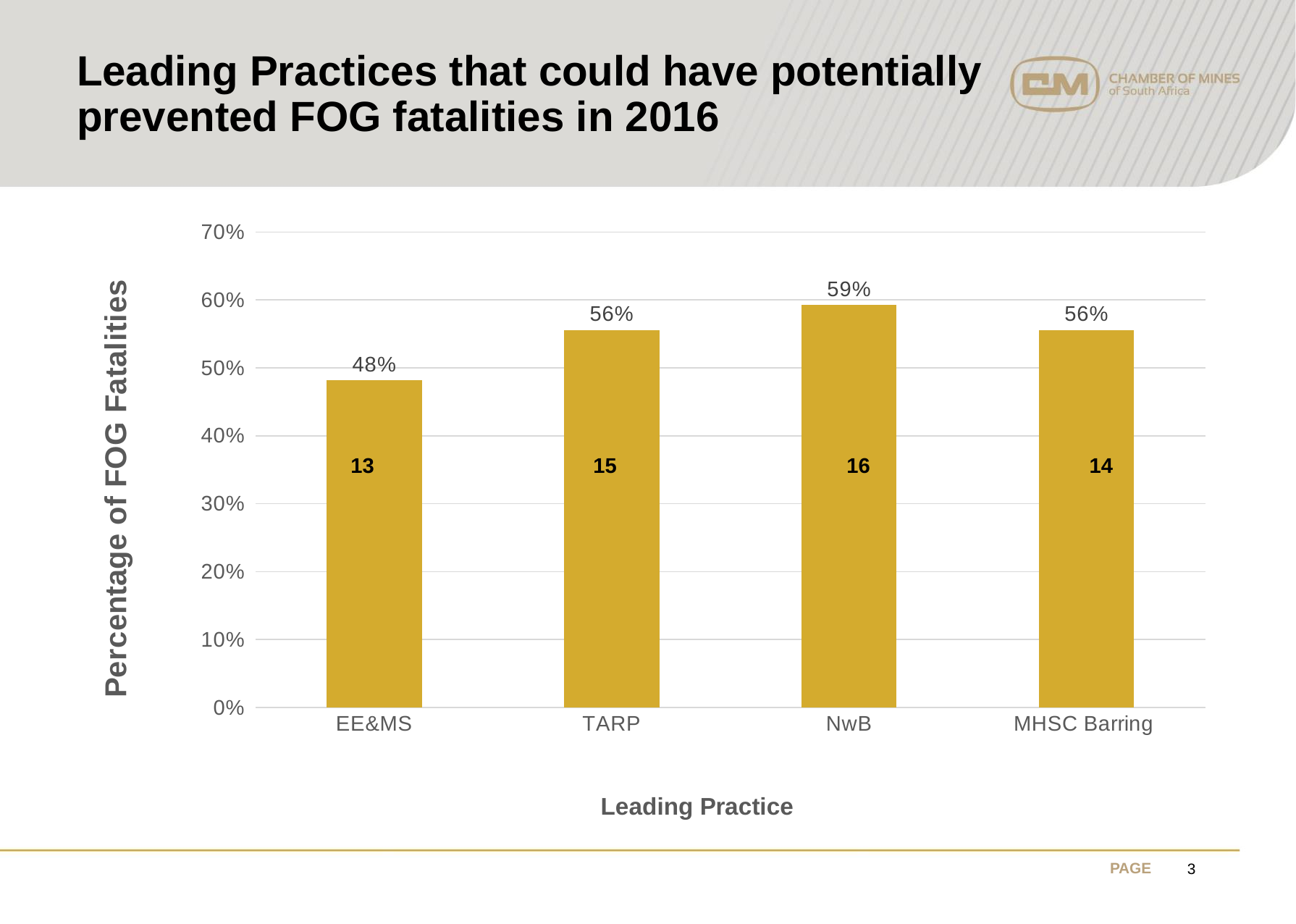
What is the difference in percentage points between NwB and EE&MS? 11 What number is printed inside the MHSC Barring bar? 14 What number is printed inside the TARP bar? 15 Which leading practice has the lowest percentage of FOG fatalities? EE&MS Is the value for EE&MS greater or less than 50%? less What percentage of FOG fatalities is shown for NwB? 59% What kind of chart is shown on the slide? Bar chart What is the label of the y axis? Percentage of FOG Fatalities Which leading practice has the highest percentage of FOG fatalities? NwB Which has a higher percentage, EE&MS or TARP? TARP How many leading practices are shown on the x axis? 4 What percentage of FOG fatalities is shown for EE&MS? 48%